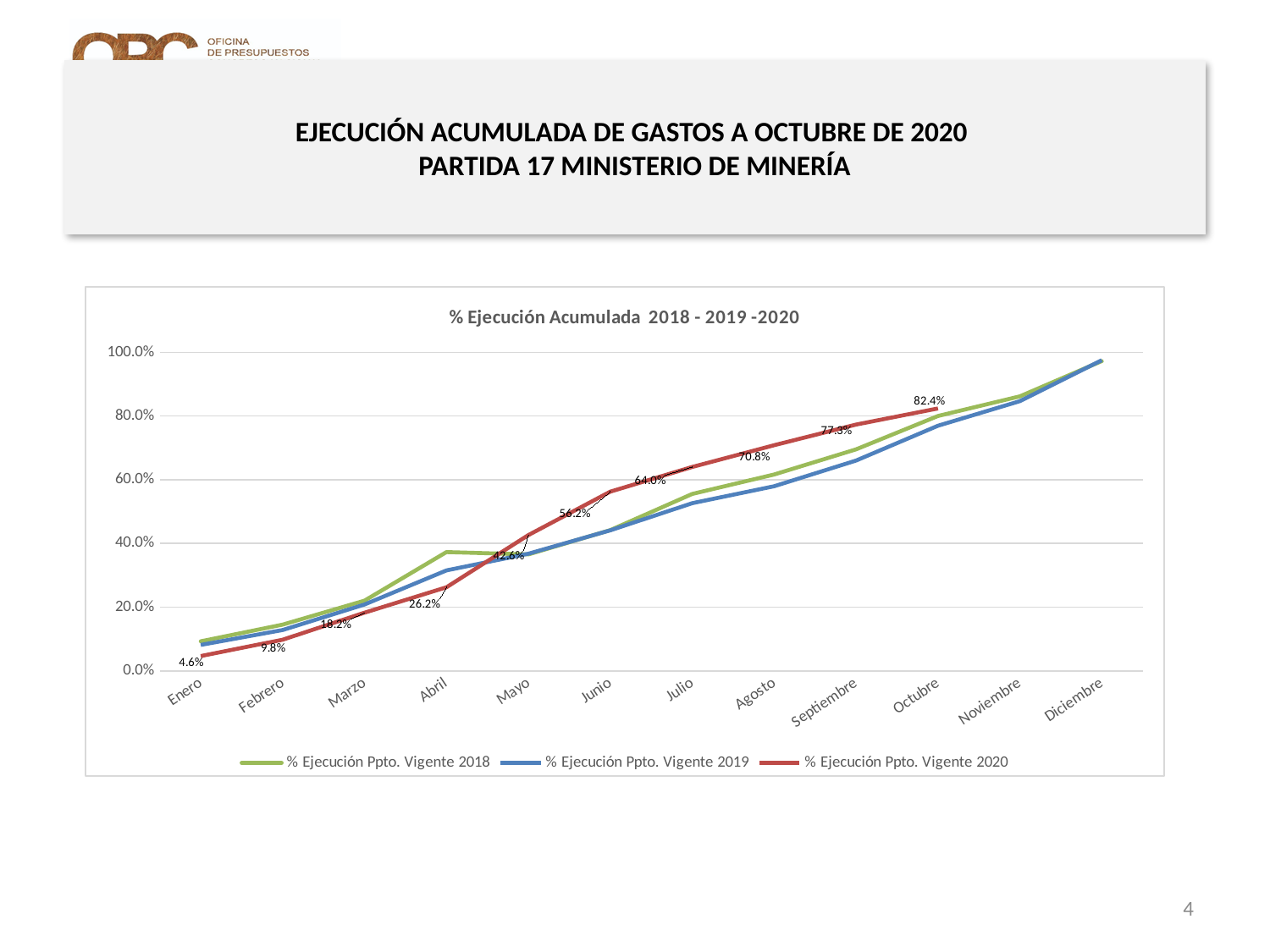
What is the value for % Ejecución Ppto. Vigente 2020 in Junio? 56.2% Does the % Ejecución Ppto. Vigente 2020 line rise or fall from Enero to Octubre? rise What is the value for % Ejecución Ppto. Vigente 2020 in Enero? 4.6% How many series does the legend list? 3 What is the difference between the 2020 values for Mayo and Abril? 16.4% What kind of chart is shown on the slide? line chart What is the difference between the 2020 values for Octubre and Septiembre? 5.1% What is the chart's title? % Ejecución Acumulada 2018 - 2019 -2020 Is the value for % Ejecución Ppto. Vigente 2019 in Diciembre greater or less than 80.0%? greater How many months are shown on the x axis? 12 Which series is drawn in red? % Ejecución Ppto. Vigente 2020 What is the value for % Ejecución Ppto. Vigente 2020 in Octubre? 82.4%